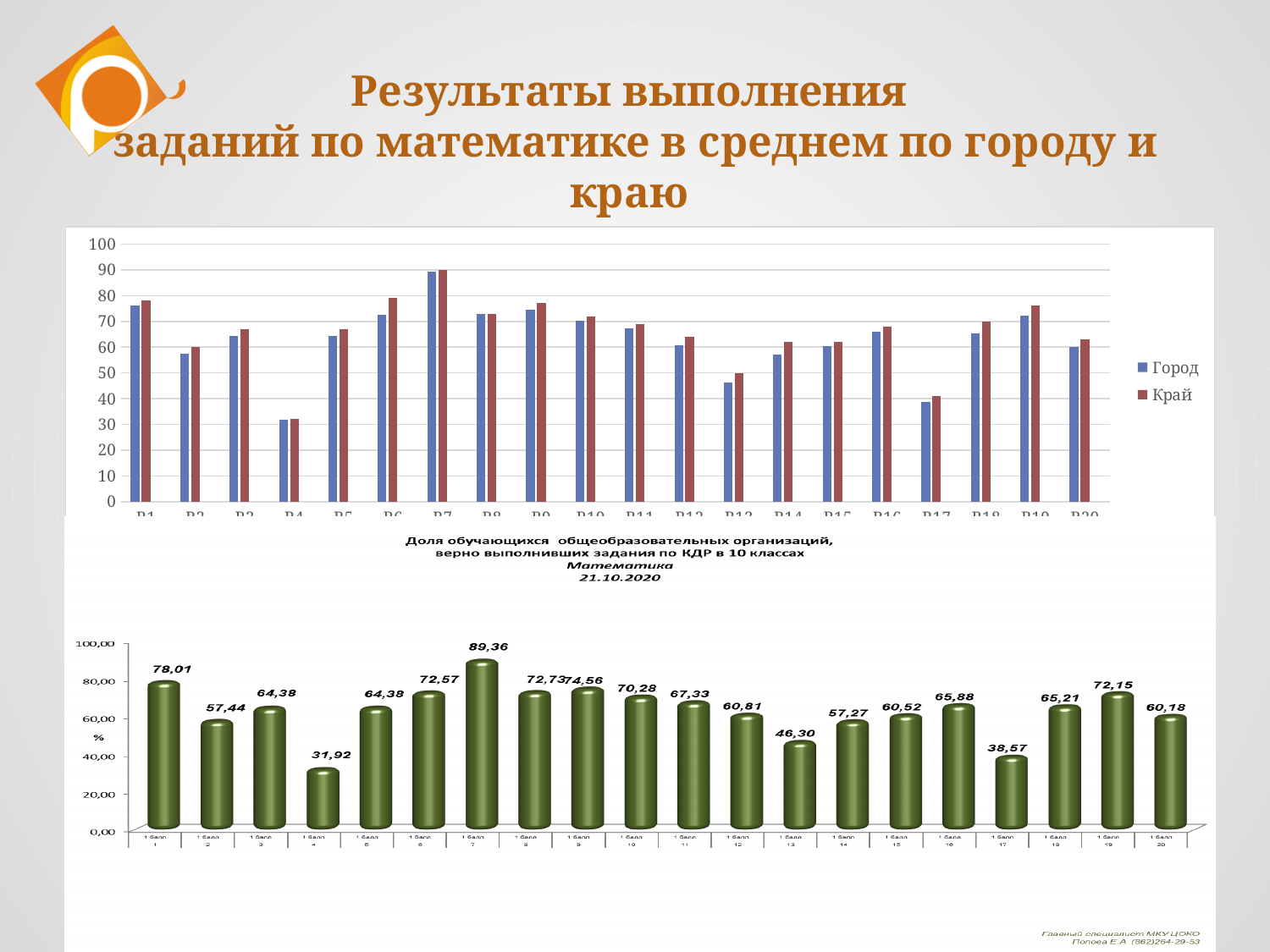
In the bottom chart, what is the value labelled on the seventh bar from the left? 89,36 In the top chart, which category has the lowest value for the Край series? В4 What kind of chart is the top chart on the slide? bar chart In the top chart, which category has the highest value for the Город series? В7 How many series does the legend of the top chart list? 2 In the bottom chart, what is the difference between the first bar (78,01) and the second bar (57,44)? 20,57 What are the two series named in the legend of the top chart? Город and Край How many bars are plotted in the bottom chart? 20 In the bottom chart, what is the value labelled on the fourth bar from the left? 31,92 In the top chart, is the Город value for В4 greater or less than 40? less In the top chart, is the Край value for В7 greater or less than 80? greater In the top chart, which is larger for В6: the Город value or the Край value? Край